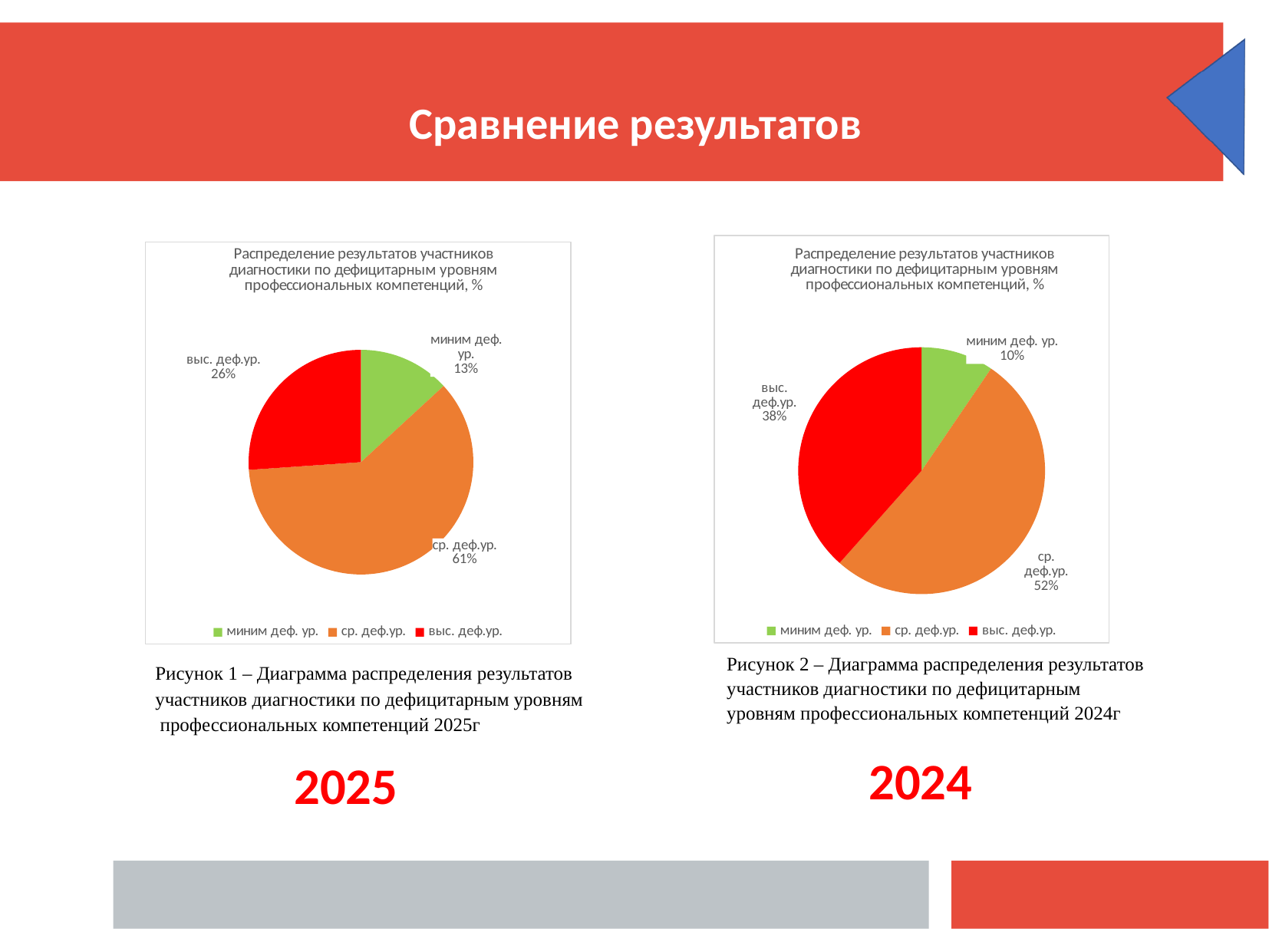
In the right (2024) pie chart, what share is labelled for 'миним деф. ур.'? 10% What type of chart is shown on the right (2024)? Pie chart Which is larger: the 'выс. деф.ур.' share in the 2025 chart or in the 2024 chart? 2024 chart How many slices does the left (2025) pie chart have? 3 In the right (2024) pie chart, which category has the smallest slice? миним деф. ур. In the left (2025) pie chart, what is the difference between the shares of 'ср. деф.ур.' and 'выс. деф.ур.'? 35% In the left (2025) pie chart, what colour is the 'выс. деф.ур.' slice? Red In the left (2025) pie chart, what share is labelled for 'выс. деф.ур.'? 26% In the left (2025) pie chart, which category has the largest slice? ср. деф.ур. In the left (2025) pie chart, what share is labelled for 'ср. деф.ур.'? 61% In the right (2024) pie chart, what is the difference between the shares of 'ср. деф.ур.' and 'выс. деф.ур.'? 14% In the right (2024) pie chart, what share is labelled for 'выс. деф.ур.'? 38%